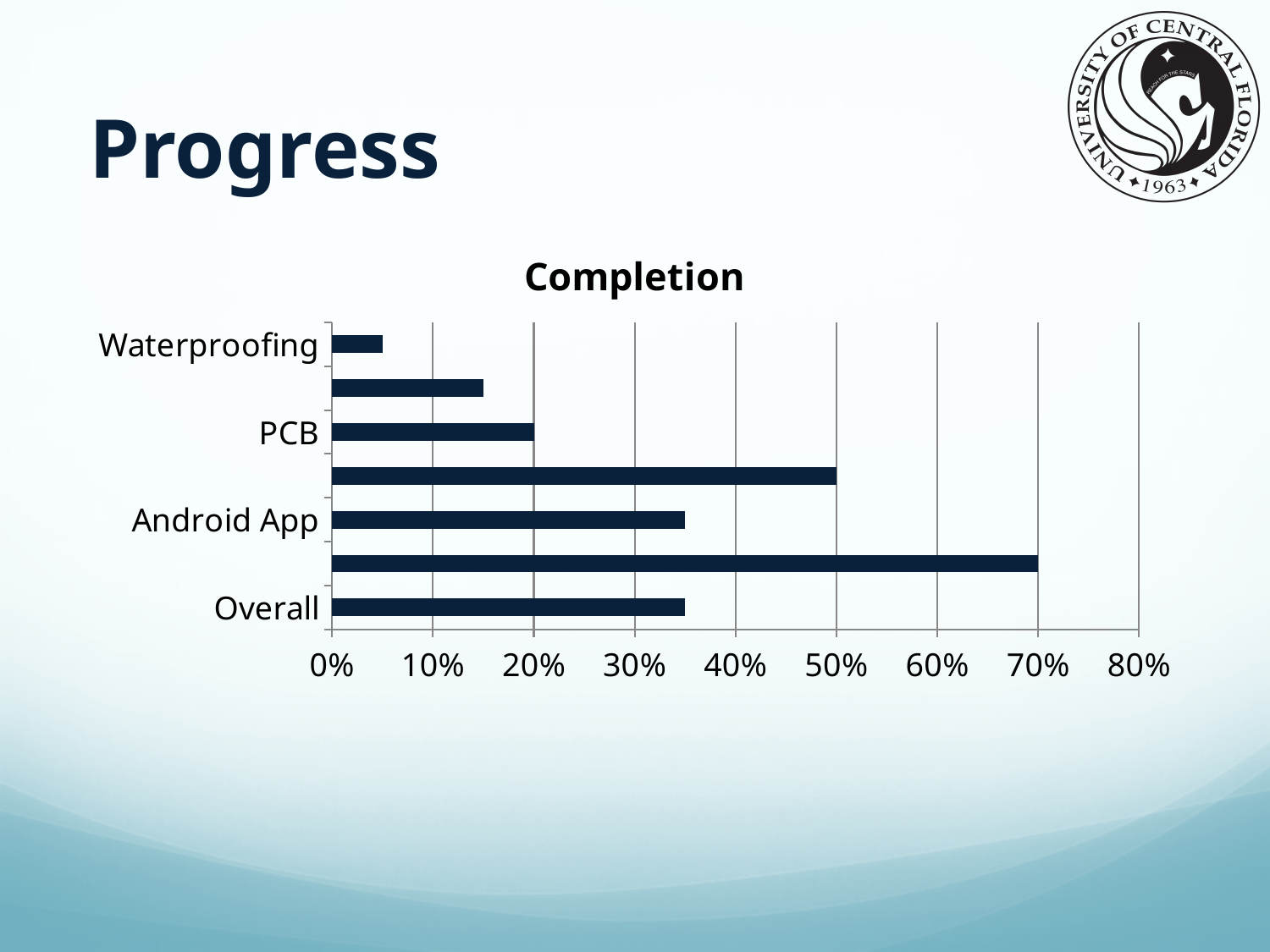
Which is larger, the value for PCB or the value for Waterproofing? PCB Is the value for Waterproofing greater or less than 10%? less How many bars are plotted in the chart? 7 What type of chart is shown on the slide? bar chart What is the completion value for PCB? 20% What is the title of the chart? Completion Which category has the lowest completion value? Waterproofing Is the value for Overall greater or less than 30%? greater Which is larger, the value for Android App or the value for PCB? Android App Is the value for Overall greater or less than 40%? less